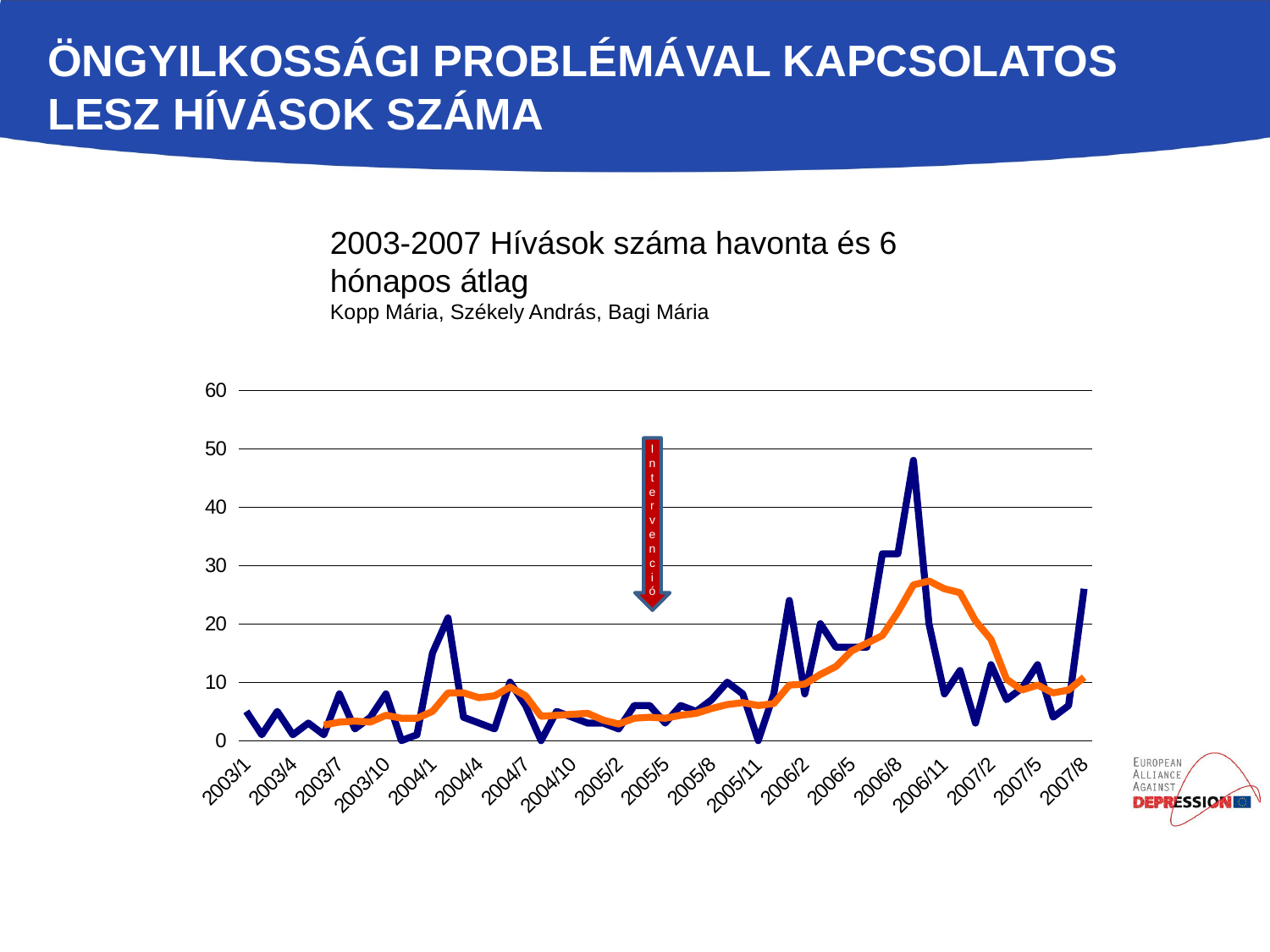
What kind of chart is shown on the slide? line chart Which line reaches a higher peak, the dark blue line or the orange line? the dark blue line Is the peak value of the orange line greater or less than 30? less What is the highest value shown on the vertical axis? 60 What is the title of the chart? 2003-2007 Hívások száma havonta és 6 hónapos átlag Is the peak value of the dark blue line greater or less than 40? greater Is the value of the dark blue line at 2007/8 greater or less than 20? greater In which year does the dark blue line reach its highest value? 2006 What word is written on the red arrow placed above the chart? Intervenció Does the orange line rise or fall between 2006/11 and 2007/2? fall How many lines are plotted on the chart? 2